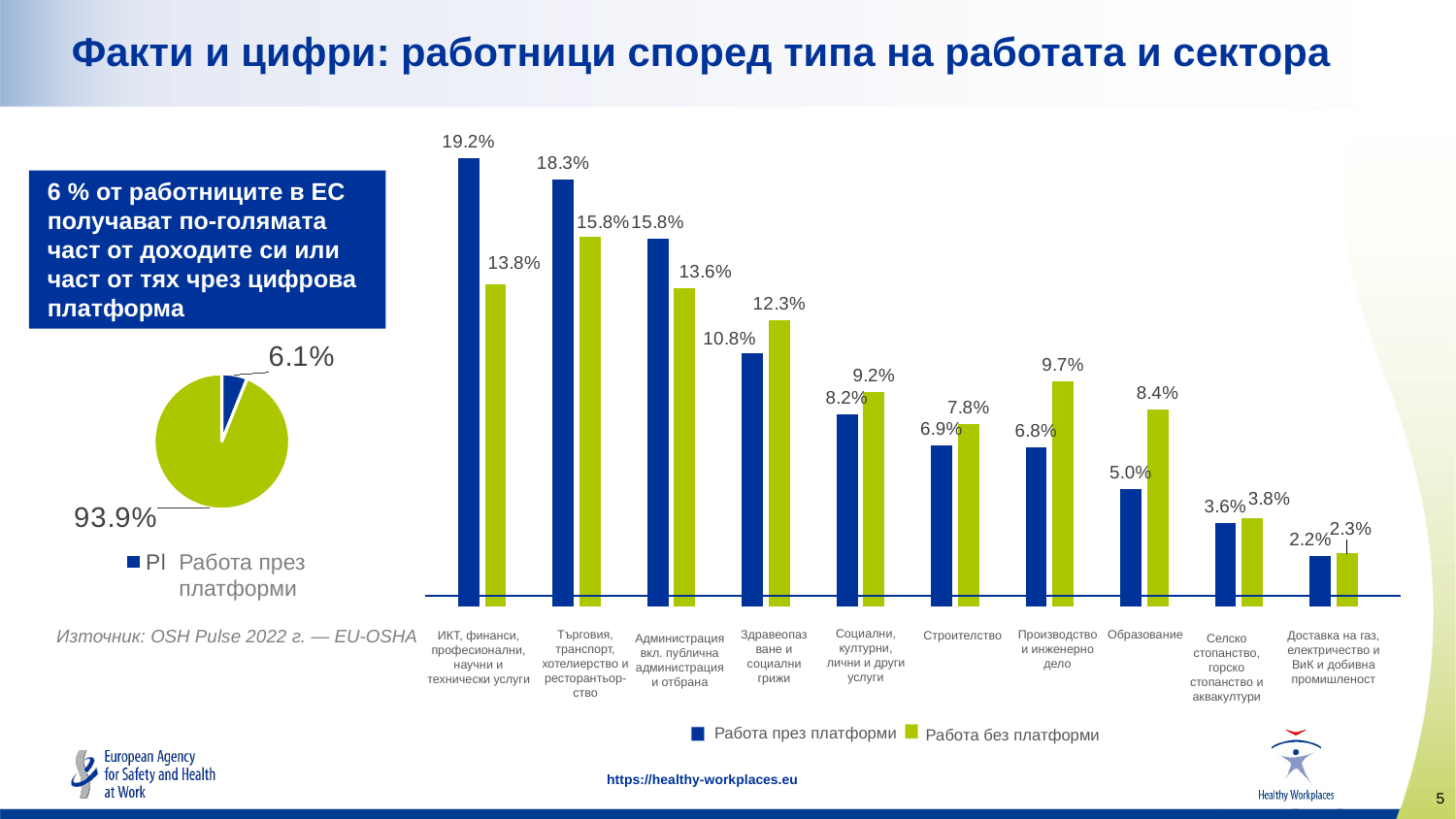
How many categories are shown on the x axis of the bar chart on the right? 10 In the bar chart on the right, which category has the highest value for 'Работа през платформи'? ИКТ, финанси, професионални, научни и технически услуги In the bar chart on the right, which is larger in the 'Здравеопазване и социални грижи' category: 'Работа през платформи' or 'Работа без платформи'? Работа без платформи What kind of chart is the chart on the right of the slide? Bar chart In the bar chart on the right, what is the difference between 'Работа през платформи' and 'Работа без платформи' in the 'Производство и инженерно дело' category? 2.9% In the pie chart on the left, what is the value of the larger slice? 93.9% In the bar chart on the right, do the values for 'Работа през платформи' generally rise or fall from left to right along the x axis? Fall In the bar chart on the right, what is the value for 'Работа без платформи' in the 'Образование' category? 8.4% In the bar chart on the right, what is the value for 'Работа през платформи' in the 'Строителство' category? 6.9% How many series does the legend of the bar chart on the right list? 2 In the bar chart on the right, which category has the lowest value for 'Работа без платформи'? Доставка на газ, електричество и ВиК и добивна промишленост In the pie chart on the left, what share is shown for the 'Работа през платформи' slice? 6.1%